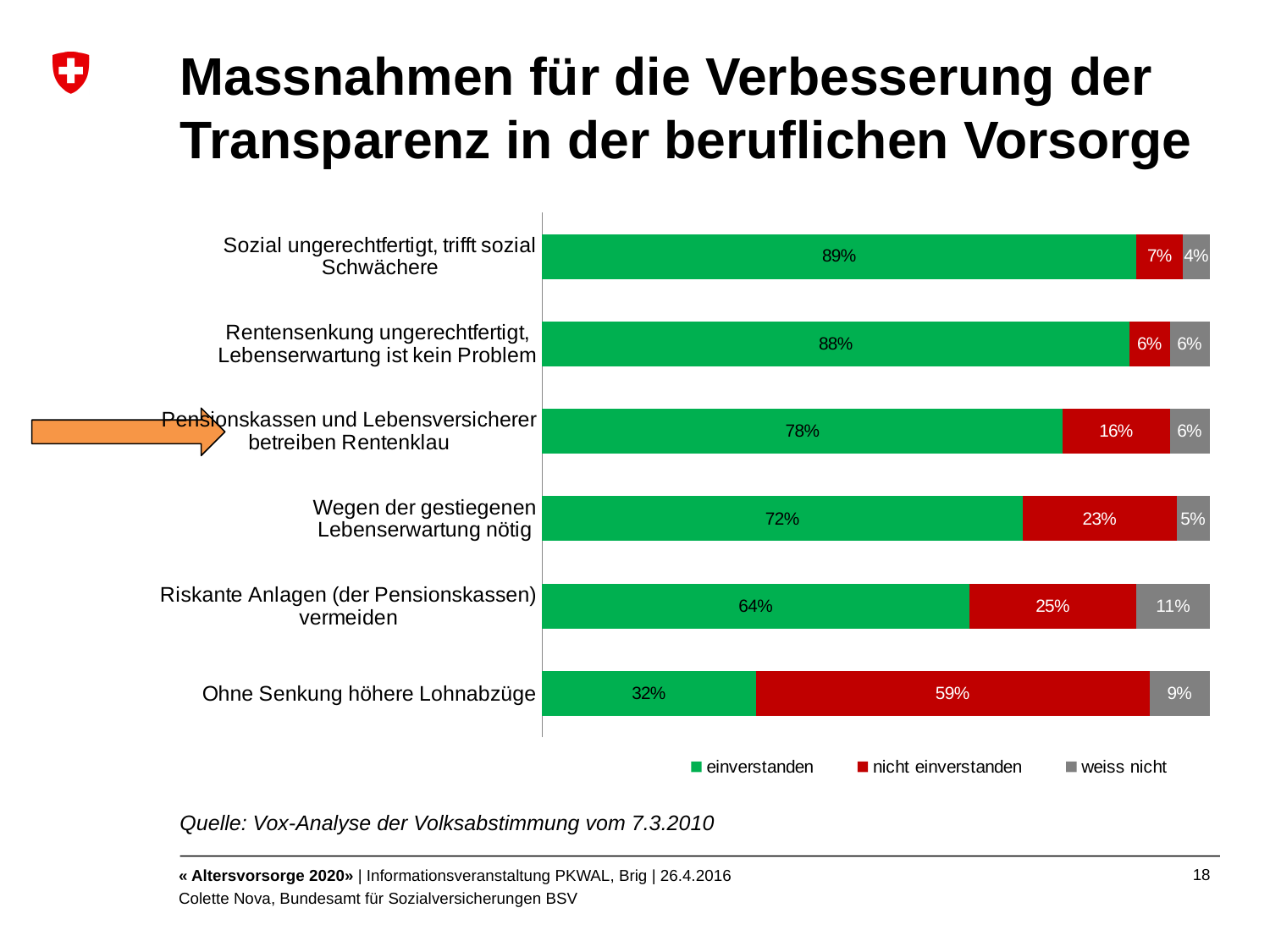
What kind of chart is shown on the slide? Stacked bar chart Which statement has the lowest 'einverstanden' share? Ohne Senkung höhere Lohnabzüge What is the 'weiss nicht' value for 'Riskante Anlagen (der Pensionskassen) vermeiden'? 11% What is the difference between the 'nicht einverstanden' values for 'Wegen der gestiegenen Lebenserwartung nötig' and 'Pensionskassen und Lebensversicherer betreiben Rentenklau'? 7% Which is larger: the 'einverstanden' value for 'Riskante Anlagen (der Pensionskassen) vermeiden' or for 'Wegen der gestiegenen Lebenserwartung nötig'? Wegen der gestiegenen Lebenserwartung nötig How many series does the legend list? 3 What is the total of the stacked bar for 'Pensionskassen und Lebensversicherer betreiben Rentenklau'? 100% How many categories (statements) are shown in the chart? 6 What is the 'einverstanden' value for 'Sozial ungerechtfertigt, trifft sozial Schwächere'? 89% Which statement has the highest 'einverstanden' share? Sozial ungerechtfertigt, trifft sozial Schwächere Which colour represents 'nicht einverstanden' in the chart? Red What is the 'nicht einverstanden' value for 'Ohne Senkung höhere Lohnabzüge'? 59%